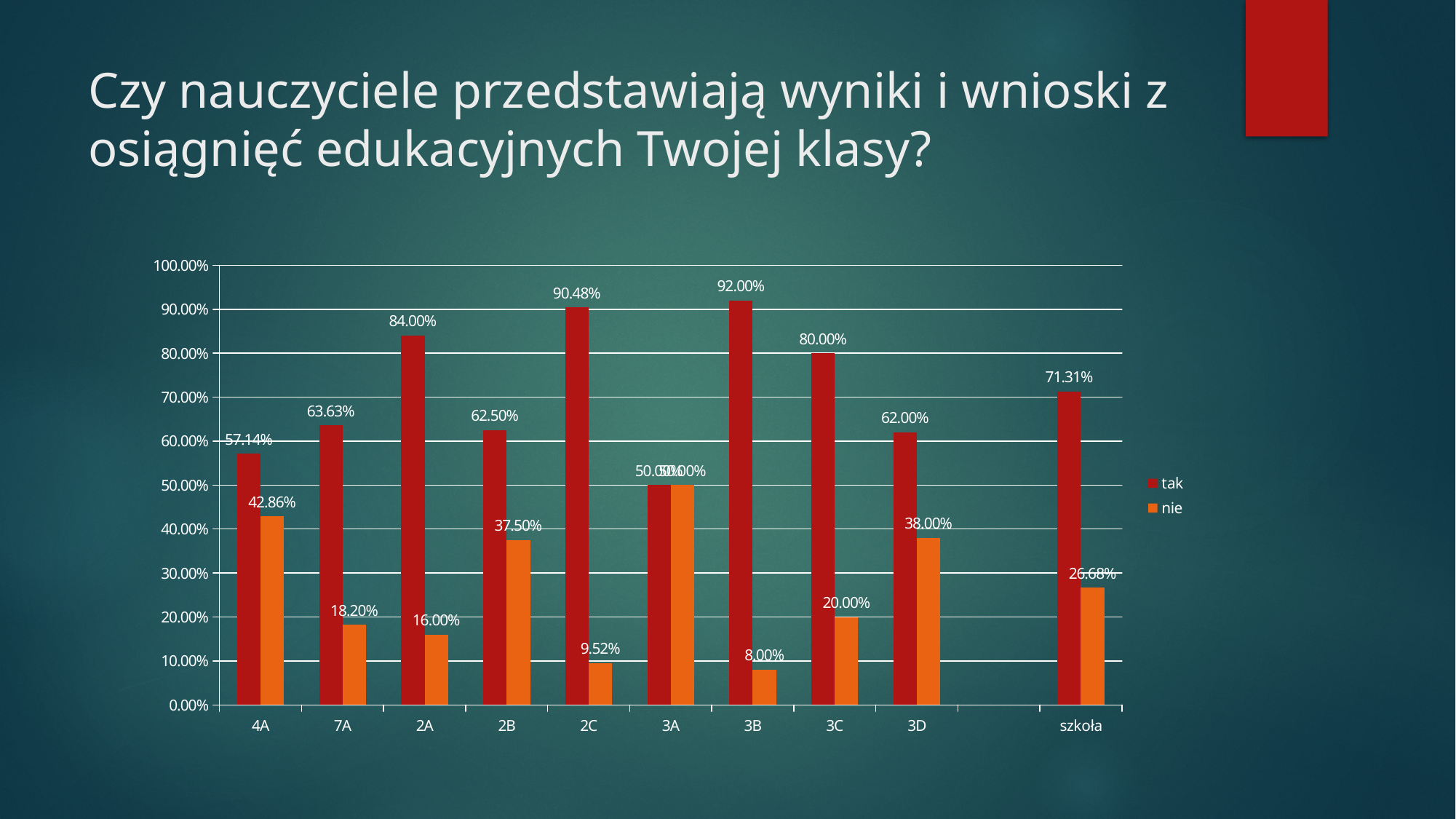
What is the value of "tak" for szkoła? 71.31% Which is larger: the "tak" value for 2C or the "tak" value for 3C? 2C What kind of chart is shown on the slide? bar chart What is the value of "nie" for class 4A? 42.86% What is the difference between the "tak" and "nie" values for class 2A? 68.00% Which category has the lowest "nie" value? 3B How many series does the legend list? 2 Which category has the highest "tak" value? 3B What is the value of "tak" for class 3B? 92.00% What is the value of "nie" for class 2C? 9.52% How many categories are shown on the x axis? 10 Is the "nie" value for class 3D greater or less than 30.00%? greater